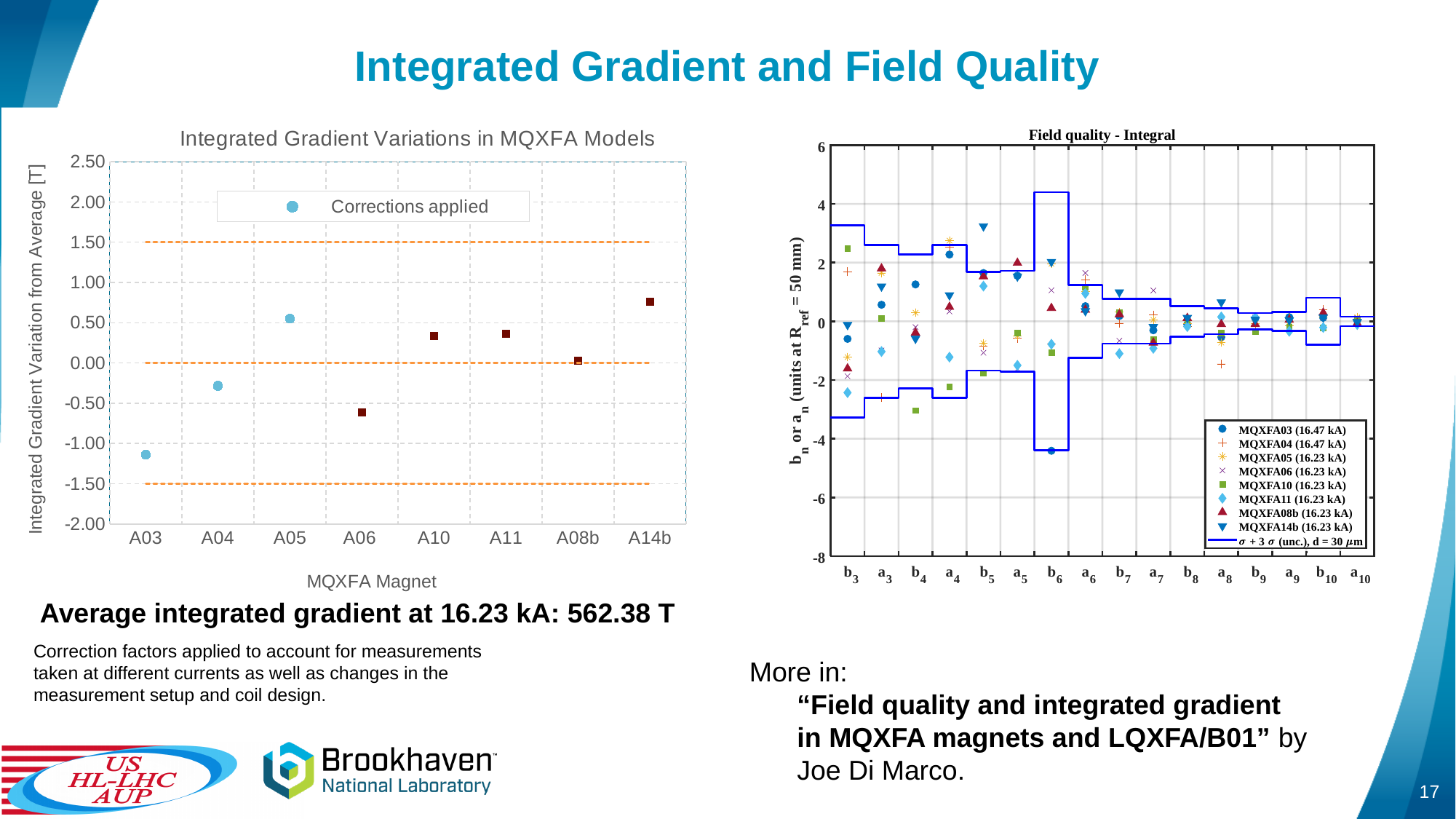
How many entries does the legend of the right chart list? 9 On the left chart, is the value for A06 greater or less than -0.50? less On the left chart, which magnet has the lowest integrated gradient variation? A03 How many harmonic categories are shown on the x axis of the right chart? 16 What is the legend entry on the left chart? Corrections applied What is the title of the right chart? Field quality - Integral On the left chart, which magnet has the highest integrated gradient variation? A14b What kind of chart is the left chart, 'Integrated Gradient Variations in MQXFA Models'? scatter chart On the left chart, is the value for A03 greater or less than -1.00? less How many magnets are plotted on the left chart's x axis? 8 On the left chart, is the value for A14b greater or less than 0.50? greater On the left chart, which has the larger value, A05 or A04? A05